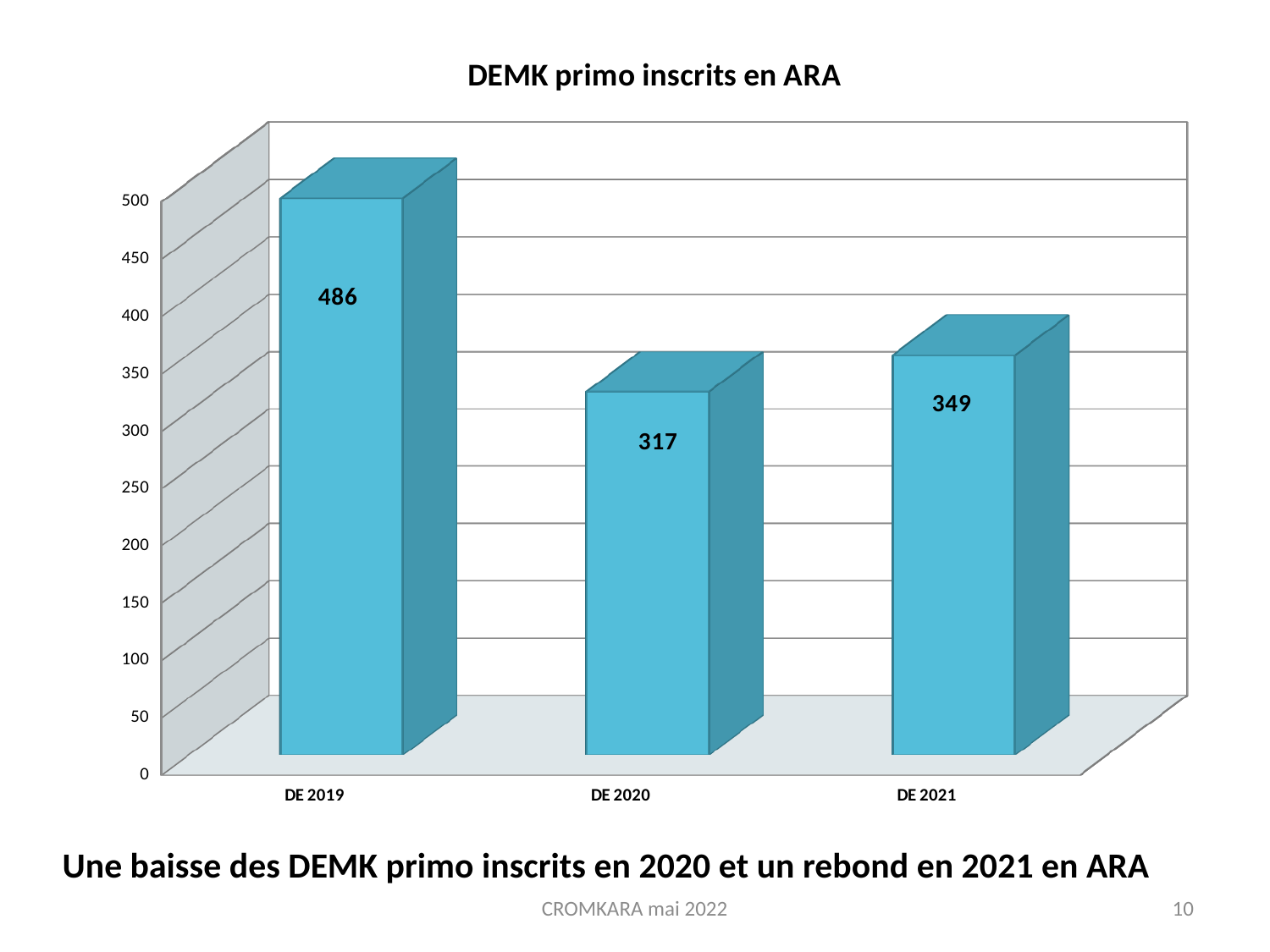
What is the value for DE 2021? 349 What is the value for DE 2020? 317 What is the difference between the values for DE 2021 and DE 2020? 32 Which is larger, the value for DE 2020 or the value for DE 2021? DE 2021 Is the value for DE 2019 greater or less than 450? greater Which category has the highest value? DE 2019 What is the difference between the values for DE 2019 and DE 2020? 169 How many categories are shown on the x axis? 3 What is the value for DE 2019? 486 Which category has the lowest value? DE 2020 What kind of chart is shown on the slide? bar chart What is the title of the chart? DEMK primo inscrits en ARA